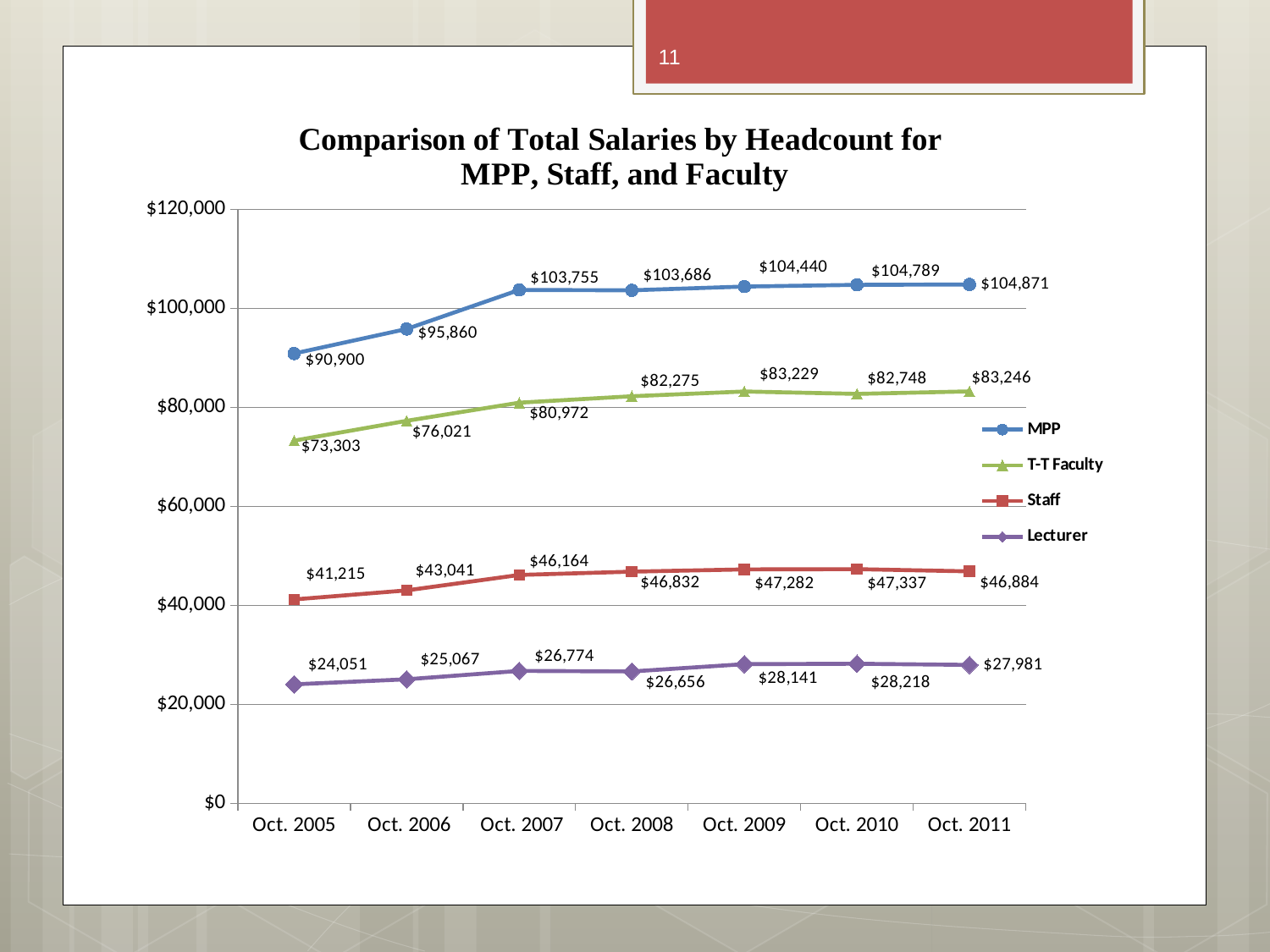
What kind of chart is shown on the slide? line chart What is the difference between the MPP value in Oct. 2011 and in Oct. 2005? $13,971 What is the Lecturer value for Oct. 2011? $27,981 Which is larger, the Staff value for Oct. 2010 or for Oct. 2011? Oct. 2010 What is the Staff value for Oct. 2005? $41,215 In which year is the MPP value highest? Oct. 2011 How many series does the legend list? 4 How many time points are shown on the x axis? 7 Is the T-T Faculty value for Oct. 2005 greater or less than $80,000? less What is the difference between the Staff value in Oct. 2007 and in Oct. 2006? $3,123 What is the MPP value for Oct. 2007? $103,755 In which year is the T-T Faculty value lowest? Oct. 2005